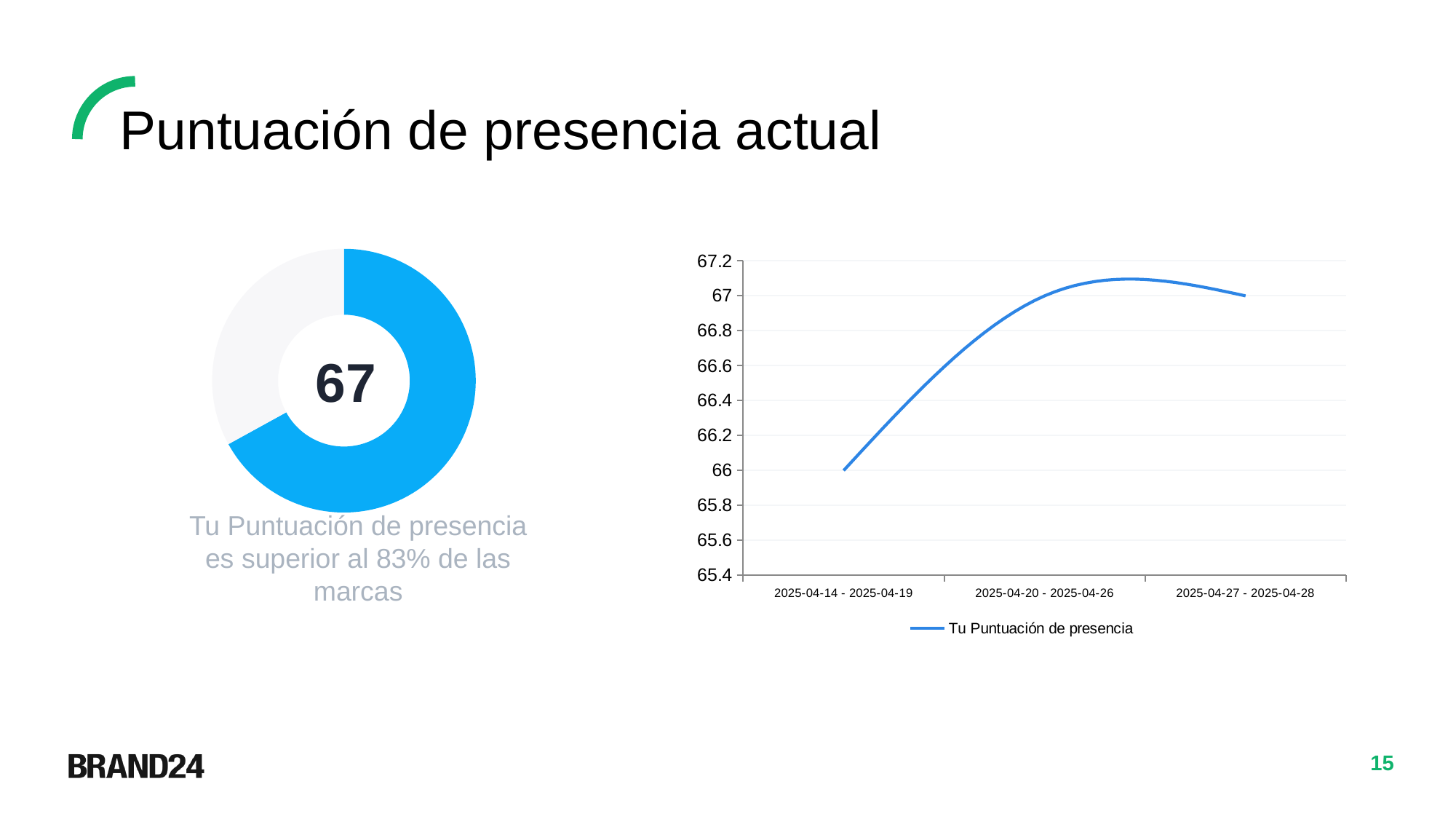
How many series does the legend of the line chart list? 1 What kind of chart is the chart on the right side of the slide? line chart On the line chart, which period has the lowest value? 2025-04-14 - 2025-04-19 On the line chart, which is larger: the value for 2025-04-14 - 2025-04-19 or for 2025-04-27 - 2025-04-28? 2025-04-27 - 2025-04-28 What number is shown in the centre of the donut chart on the left? 67 How many periods are plotted on the line chart? 3 On the line chart, is the value for 2025-04-14 - 2025-04-19 greater or less than 66.4? less On the line chart, what is the difference between the values for 2025-04-27 - 2025-04-28 and 2025-04-14 - 2025-04-19? 1 On the line chart, what is the value of Tu Puntuación de presencia for 2025-04-27 - 2025-04-28? 67 On the line chart, what is the value of Tu Puntuación de presencia for 2025-04-14 - 2025-04-19? 66